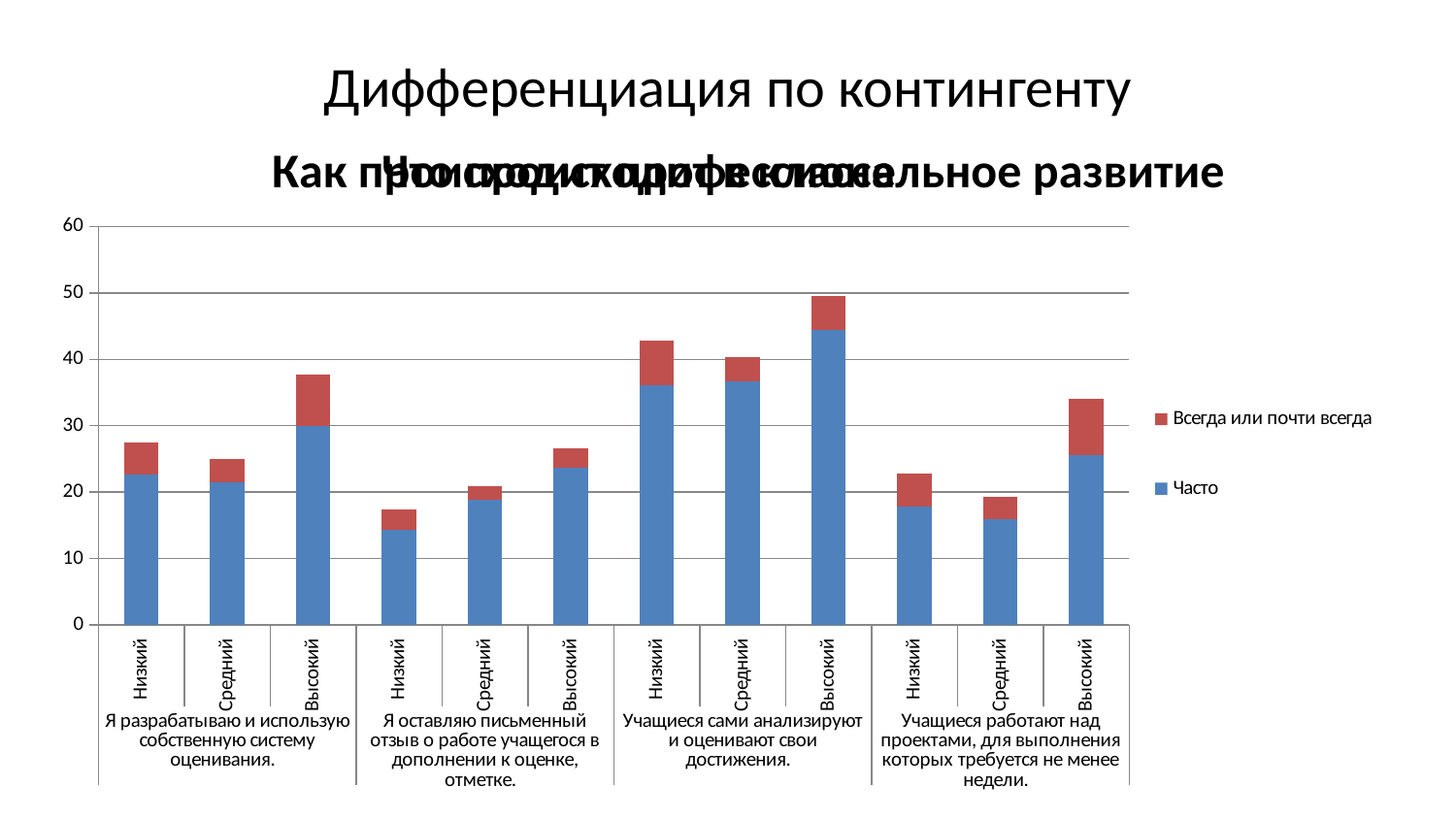
Within the group "Я оставляю письменный отзыв о работе учащегося в дополнении к оценке, отметке.", which category has the shortest bar? Низкий Which colour represents the series "Часто"? Blue Which bar is the tallest in the whole chart? Высокий in "Учащиеся сами анализируют и оценивают свои достижения." Is the total value for Высокий in "Учащиеся сами анализируют и оценивают свои достижения." greater or less than 40? greater How many series does the legend list? 2 Within the group "Я разрабатываю и использую собственную систему оценивания.", which category has the tallest bar? Высокий How many statement groups are shown along the x axis? 4 Is the total value for Низкий in "Я оставляю письменный отзыв о работе учащегося в дополнении к оценке, отметке." greater or less than 20? less What kind of chart is shown on the slide? Stacked bar chart How many bars are plotted in the chart? 12 Which is taller: the Высокий bar for "Я оставляю письменный отзыв о работе учащегося в дополнении к оценке, отметке." or the Высокий bar for "Учащиеся работают над проектами, для выполнения которых требуется не менее недели."? Учащиеся работают над проектами, для выполнения которых требуется не менее недели. What are the two series named in the legend? Всегда или почти всегда; Часто